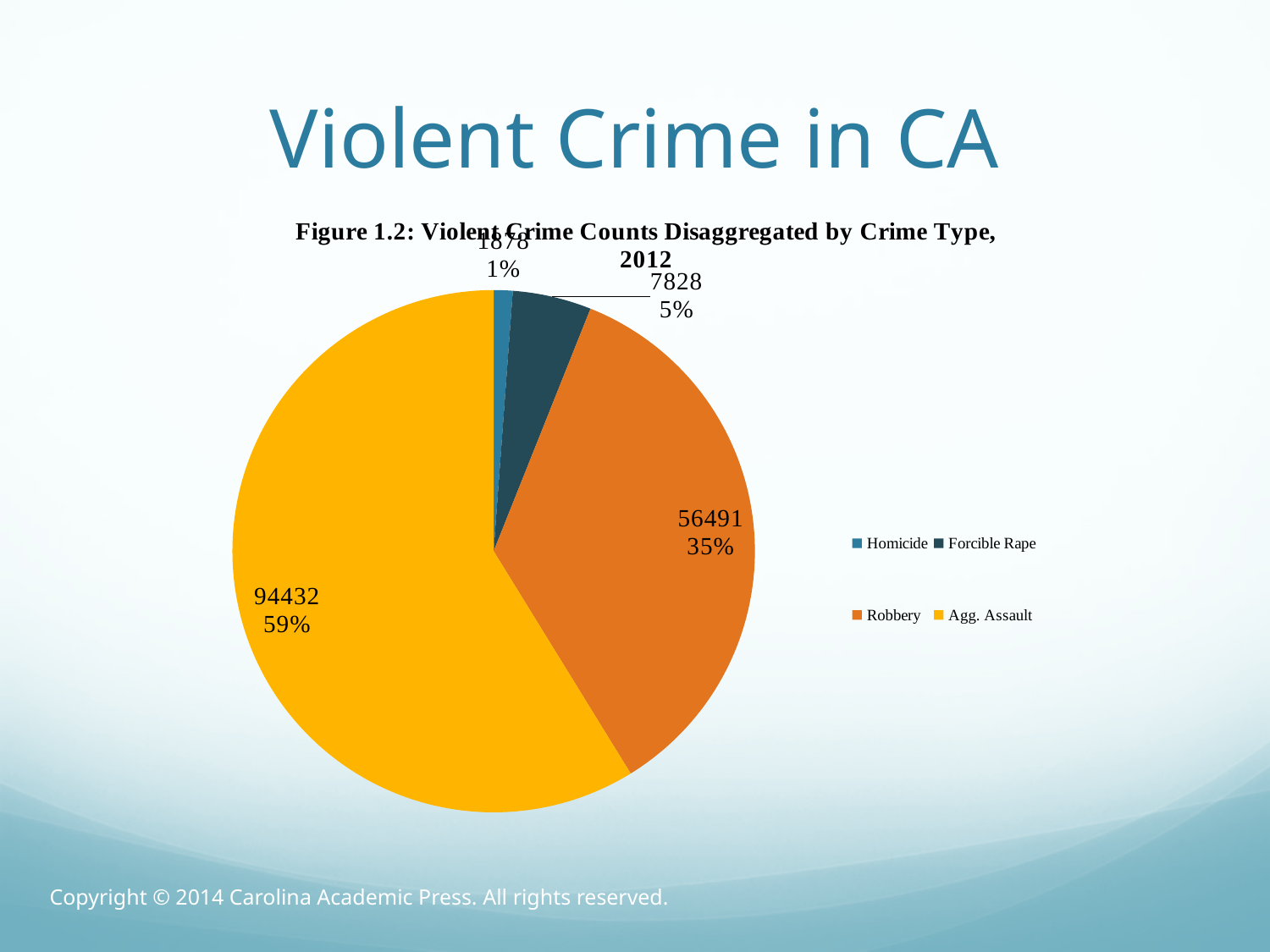
What is the count for Agg. Assault? 94432 How many crime types does the legend list? 4 What share of the pie does Robbery represent? 35% What is the count for Forcible Rape? 7828 Which is larger, the count for Robbery or the count for Forcible Rape? Robbery What is the difference between the Agg. Assault count and the Robbery count? 37941 Which crime type has the smallest slice? Homicide Which crime type has the largest slice? Agg. Assault What is the count for Robbery? 56491 What type of chart is shown on the slide? pie chart What share of the pie does Homicide represent? 1% What share of the pie does Agg. Assault represent? 59%